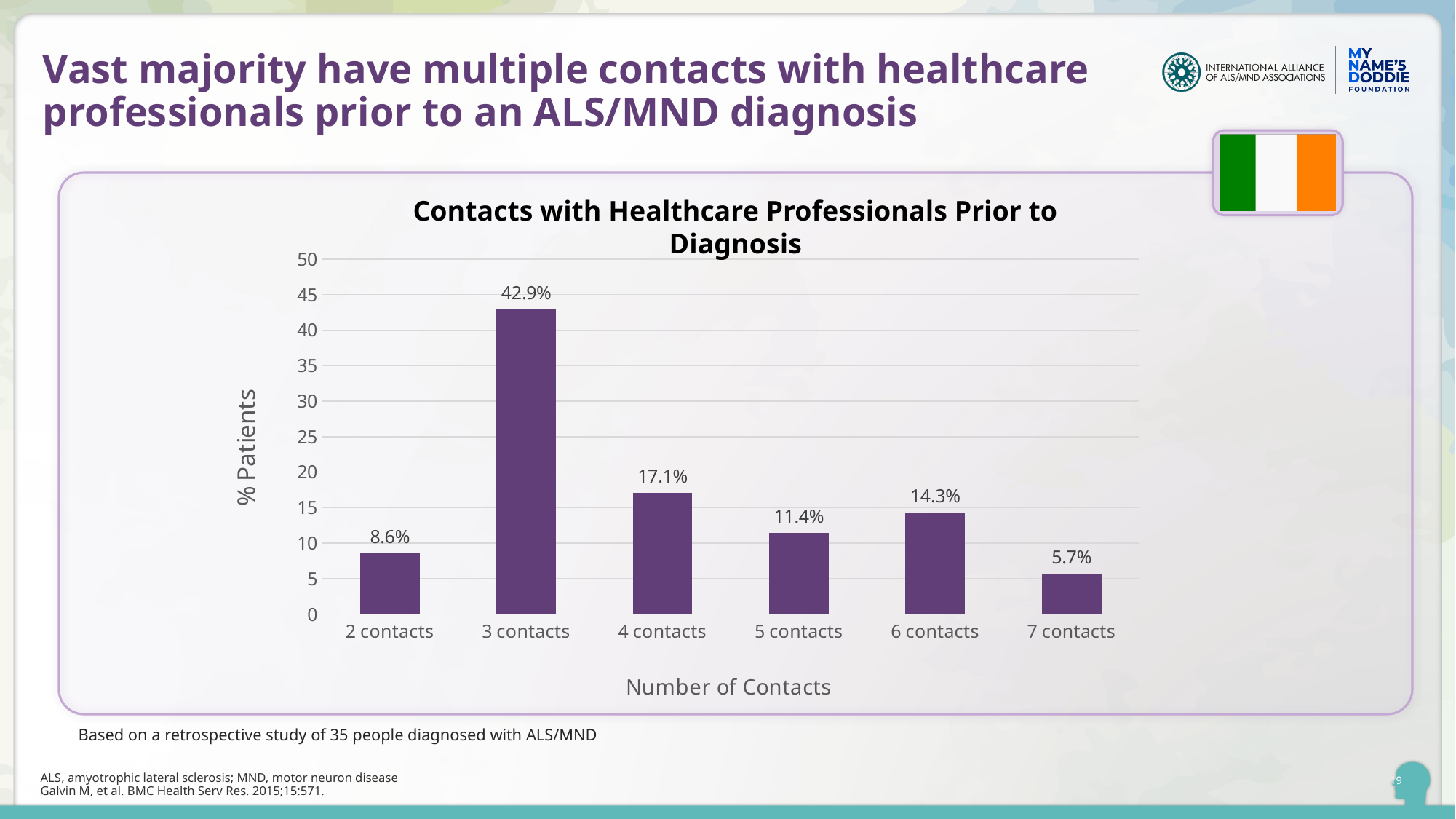
Which number of contacts has the highest percentage of patients? 3 contacts Is the value for 2 contacts greater or less than 10? less What percentage of patients had 3 contacts with healthcare professionals prior to diagnosis? 42.9% What is the difference between the values for 3 contacts and 4 contacts? 25.8% Which is larger, the value for 4 contacts or the value for 6 contacts? 4 contacts What is the value shown for 5 contacts? 11.4% What is the difference between the values for 6 contacts and 2 contacts? 5.7% Which number of contacts has the lowest percentage of patients? 7 contacts What kind of chart is shown on the slide? Bar chart What is the label of the y axis? % Patients What percentage of patients had 7 contacts? 5.7% How many categories are shown on the x axis? 6